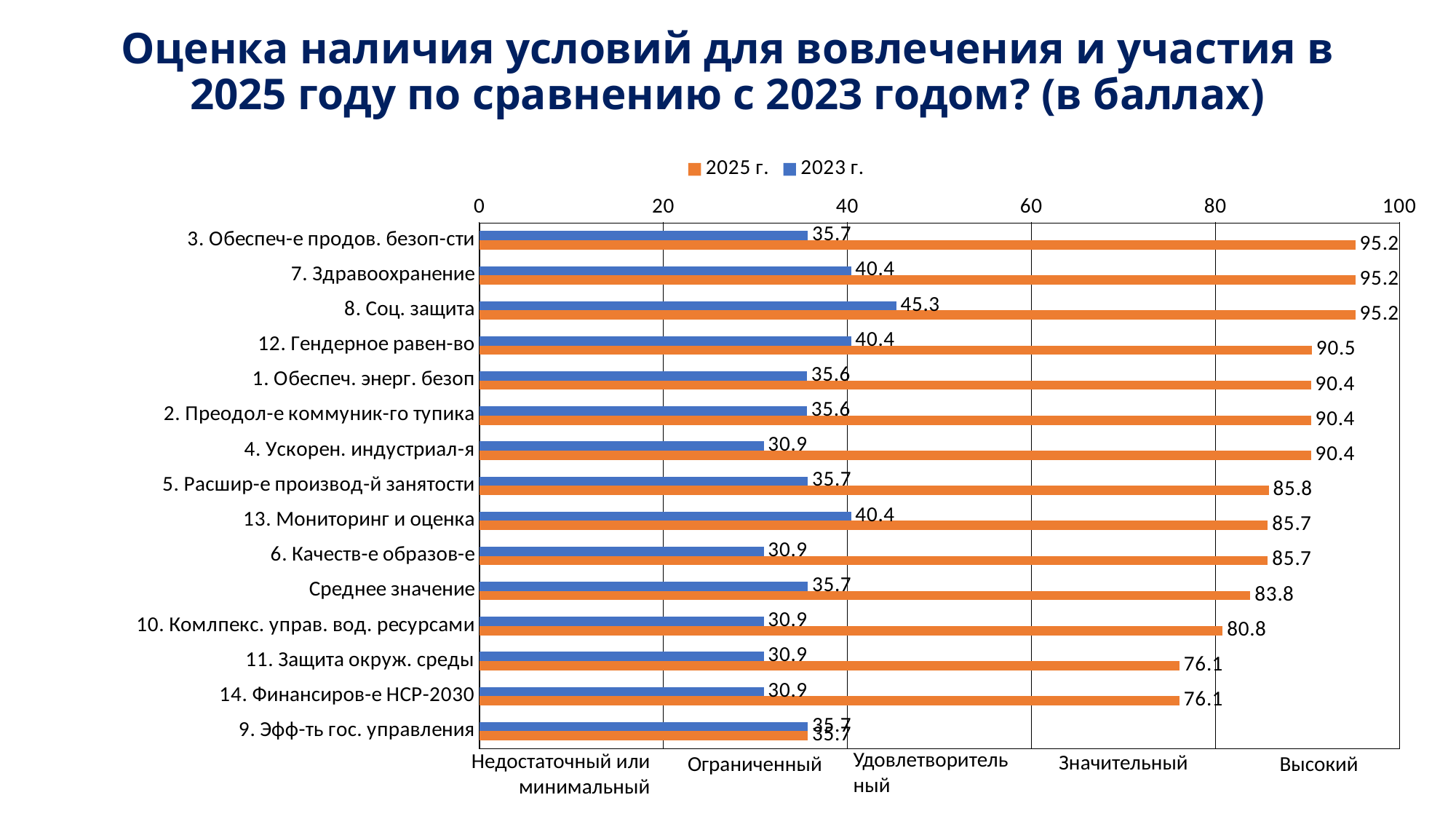
What is the 2025 г. value for Среднее значение? 83.8 How many series does the legend list? 2 Which colour represents the 2025 г. series? orange What kind of chart is shown on the slide? bar chart Which category has the highest 2023 г. value? 8. Соц. защита What is the difference between the 2025 г. and 2023 г. values for 4. Ускорен. индустриал-я? 59.5 Which category has the lowest 2025 г. value? 9. Эфф-ть гос. управления Is the 2025 г. value for 10. Комлпекс. управ. вод. ресурсами greater or less than 60? greater Which is larger for 11. Защита окруж. среды: the 2025 г. value or the 2023 г. value? 2025 г. What is the 2023 г. value for 8. Соц. защита? 45.3 How many categories are shown on the chart? 15 What is the 2025 г. value for 7. Здравоохранение? 95.2